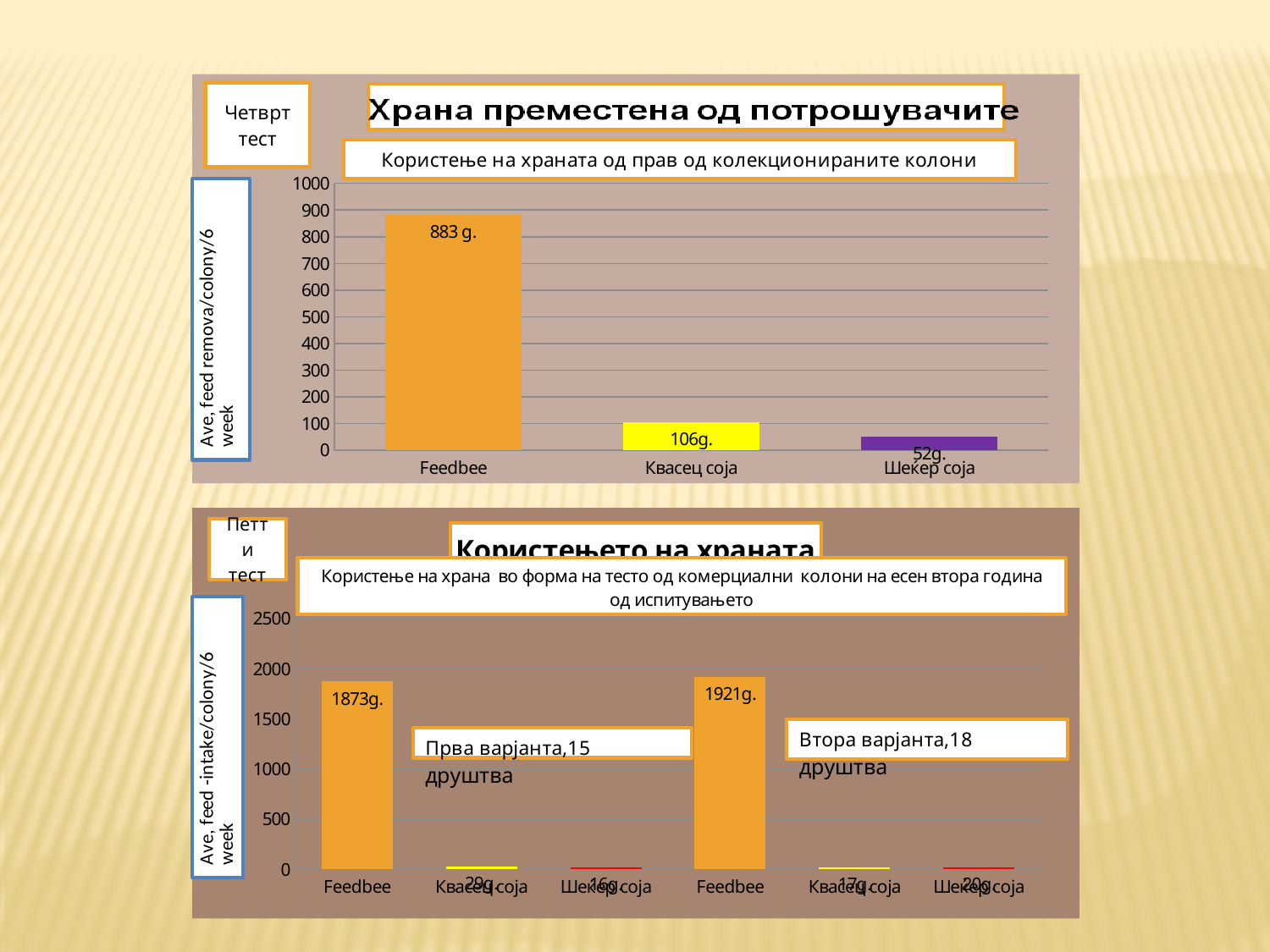
In the bottom chart (Користењето на храната), what is the value of the second Feedbee bar (Втора варјанта)? 1921g. In the bottom chart (Користењето на храната), what is the difference between the two Feedbee values? 48g. In the top chart (Храна преместена од потрошувачите), what is the value for Квасец соја? 106g. In the top chart (Храна преместена од потрошувачите), which category has the highest value? Feedbee In the top chart (Храна преместена од потрошувачите), how many categories are shown on the x axis? 3 What kind of chart is the top chart (Храна преместена од потрошувачите)? Bar chart In the top chart (Храна преместена од потрошувачите), which category has the lowest value? Шеќер соја In the top chart (Храна преместена од потрошувачите), what is the difference between the Feedbee value and the Квасец соја value? 777 g. In the top chart (Храна преместена од потрошувачите), what is the value for Feedbee? 883 g. In the bottom chart (Користењето на храната), what is the value of the first Feedbee bar (Прва варјанта)? 1873g. In the bottom chart (Користењето на храната), which Feedbee bar is larger, the one in Прва варјанта or the one in Втора варјанта? Втора варјанта In the top chart (Храна преместена од потрошувачите), what is the value for Шеќер соја? 52g.